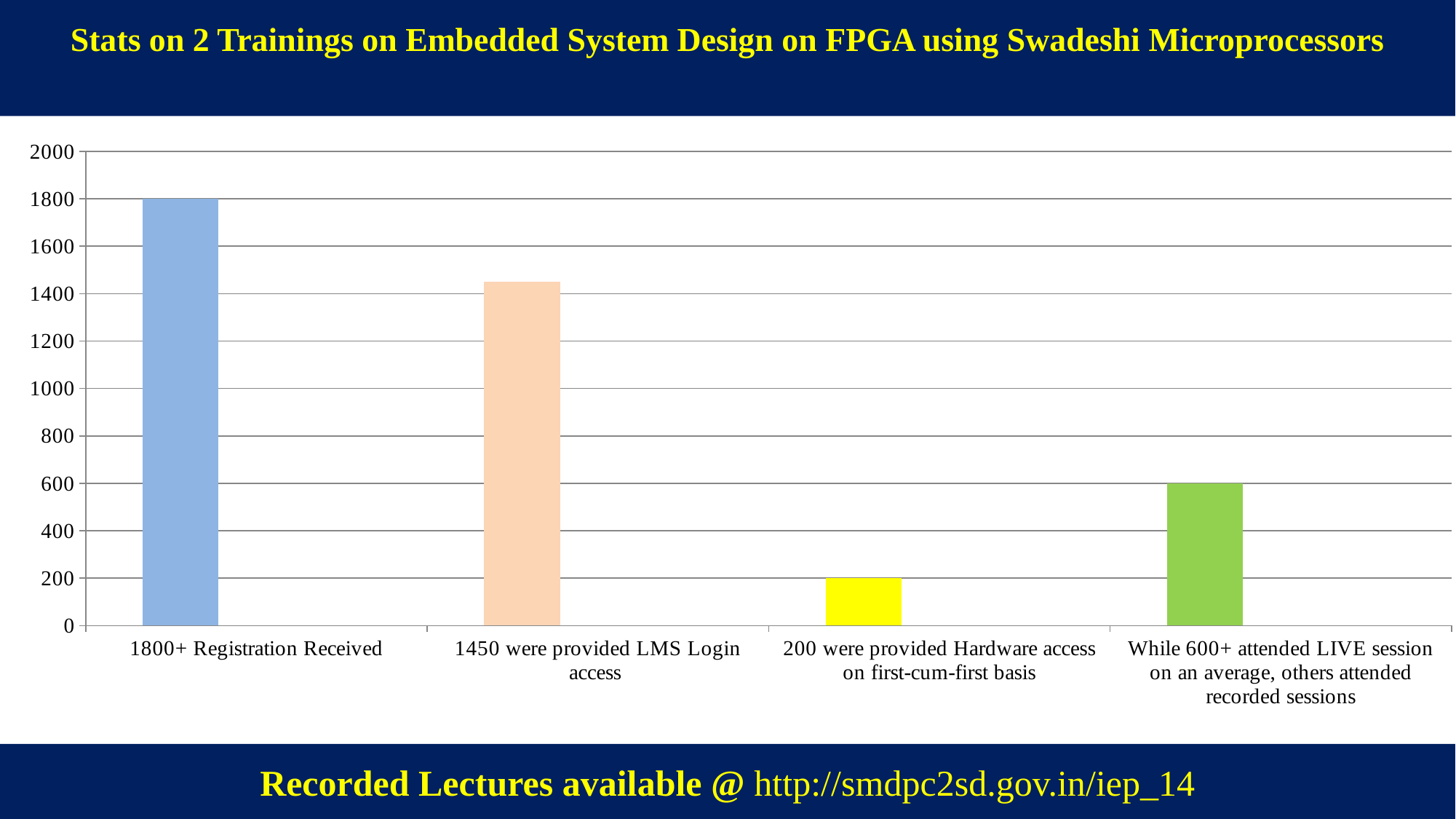
How many bars (categories) does the chart show? 4 What is the difference between the attended LIVE session bar (600) and the Hardware access bar (200)? 400 What value does the bar for '1800+ Registration Received' reach on the axis? 1800 What colour is the bar for '200 were provided Hardware access on first-cum-first basis'? Yellow What is the difference between the Registration Received bar (1800) and the Hardware access bar (200)? 1600 What value does the bar for 'While 600+ attended LIVE session on an average, others attended recorded sessions' reach on the axis? 600 Which category has the highest bar? 1800+ Registration Received Is the value for '1450 were provided LMS Login access' greater or less than 1400? greater What kind of chart is shown on the slide? Bar chart Which category has the lowest bar? 200 were provided Hardware access on first-cum-first basis What value does the bar for '200 were provided Hardware access on first-cum-first basis' reach on the axis? 200 Which is larger: the bar for LMS Login access or the bar for attended LIVE session? LMS Login access